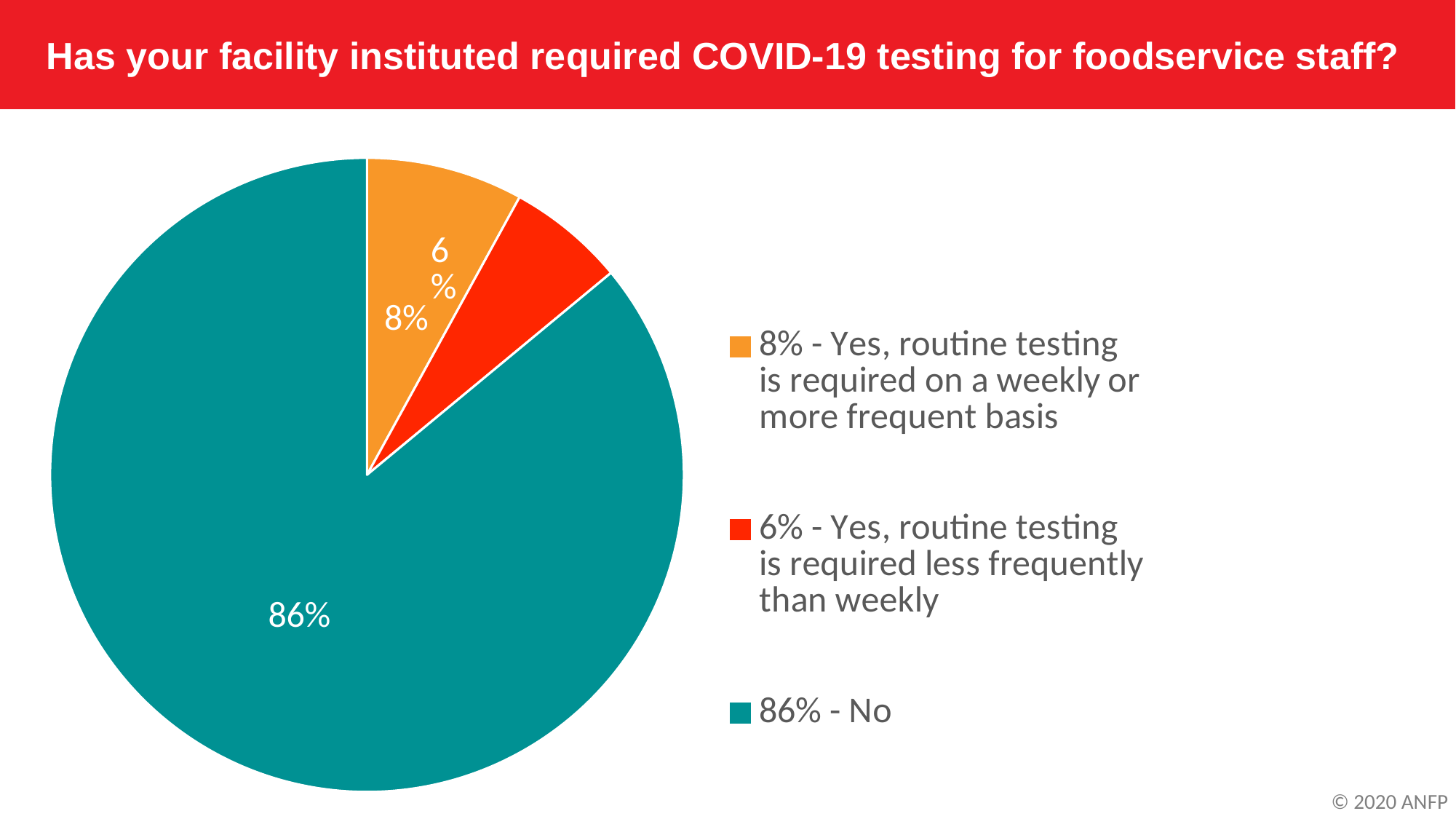
What colour is the slice representing "No"? teal How many slices does the pie chart have? 3 Which is larger: the share for weekly or more frequent testing, or the share for testing less frequently than weekly? weekly or more frequent testing What share of respondents said routine testing is required less frequently than weekly? 6% Which response has the largest slice of the pie? No How many entries does the legend list? 3 What share of respondents answered "No"? 86% What kind of chart is shown on the slide? pie chart What share of respondents said routine testing is required on a weekly or more frequent basis? 8% Which response has the smallest slice of the pie? Yes, routine testing is required less frequently than weekly What is the difference in percentage points between the "No" slice and the "weekly or more frequent" slice? 78 What is the combined share of respondents who said yes to some form of required routine testing? 14%